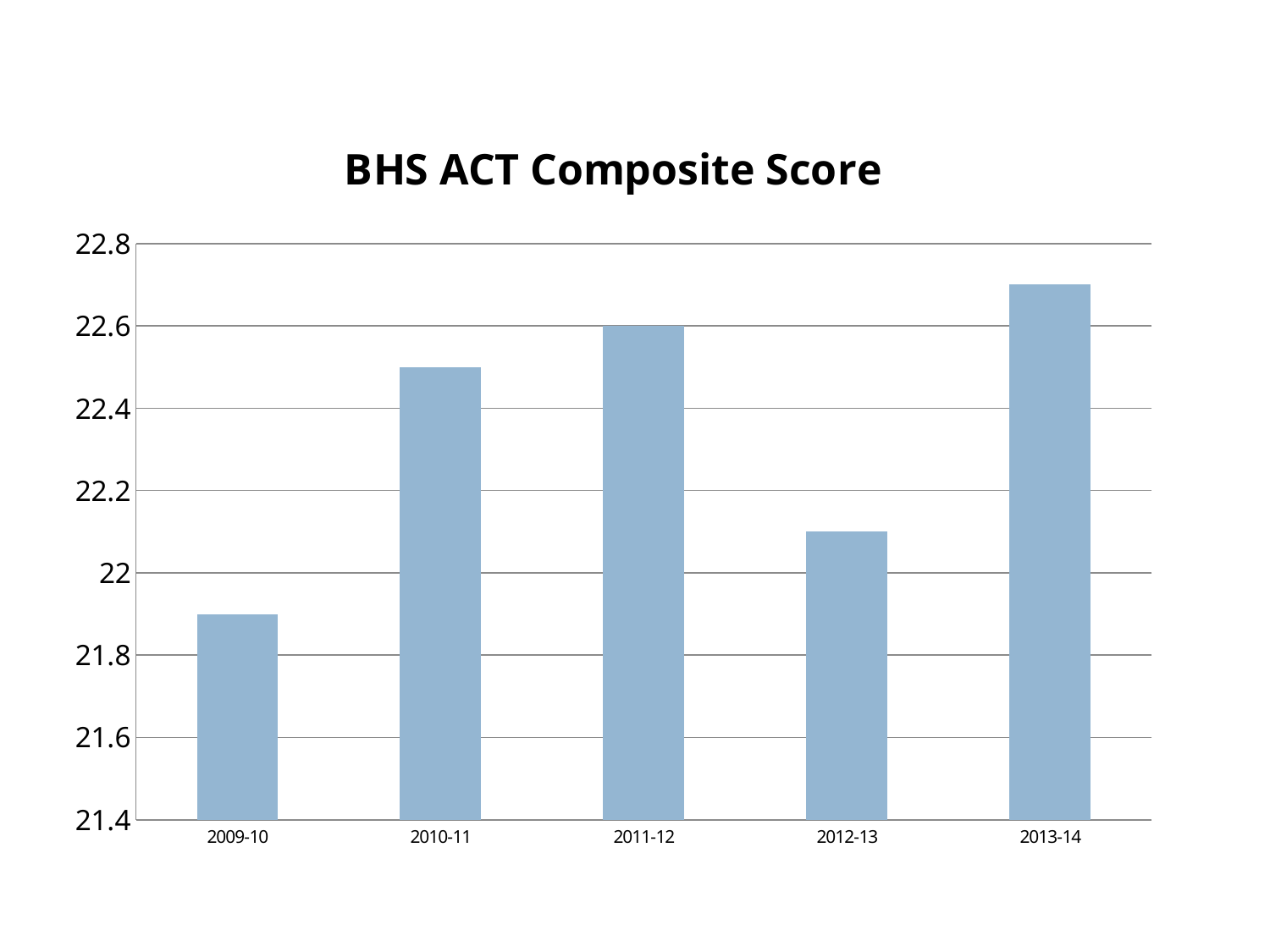
Is the value for 2012-13 greater or less than 22.2? less Do the values rise or fall from 2009-10 to 2011-12? rise Is the value for 2013-14 greater or less than 22.6? greater Which has the higher ACT composite score, 2010-11 or 2012-13? 2010-11 How many school years are shown on the x axis? 5 Is the value for 2010-11 greater or less than 22.4? greater Which school year has the highest ACT composite score? 2013-14 Which school year has the lowest ACT composite score? 2009-10 What is the ACT composite score for 2011-12? 22.6 What is the title of the chart? BHS ACT Composite Score What type of chart is shown on the slide? bar chart